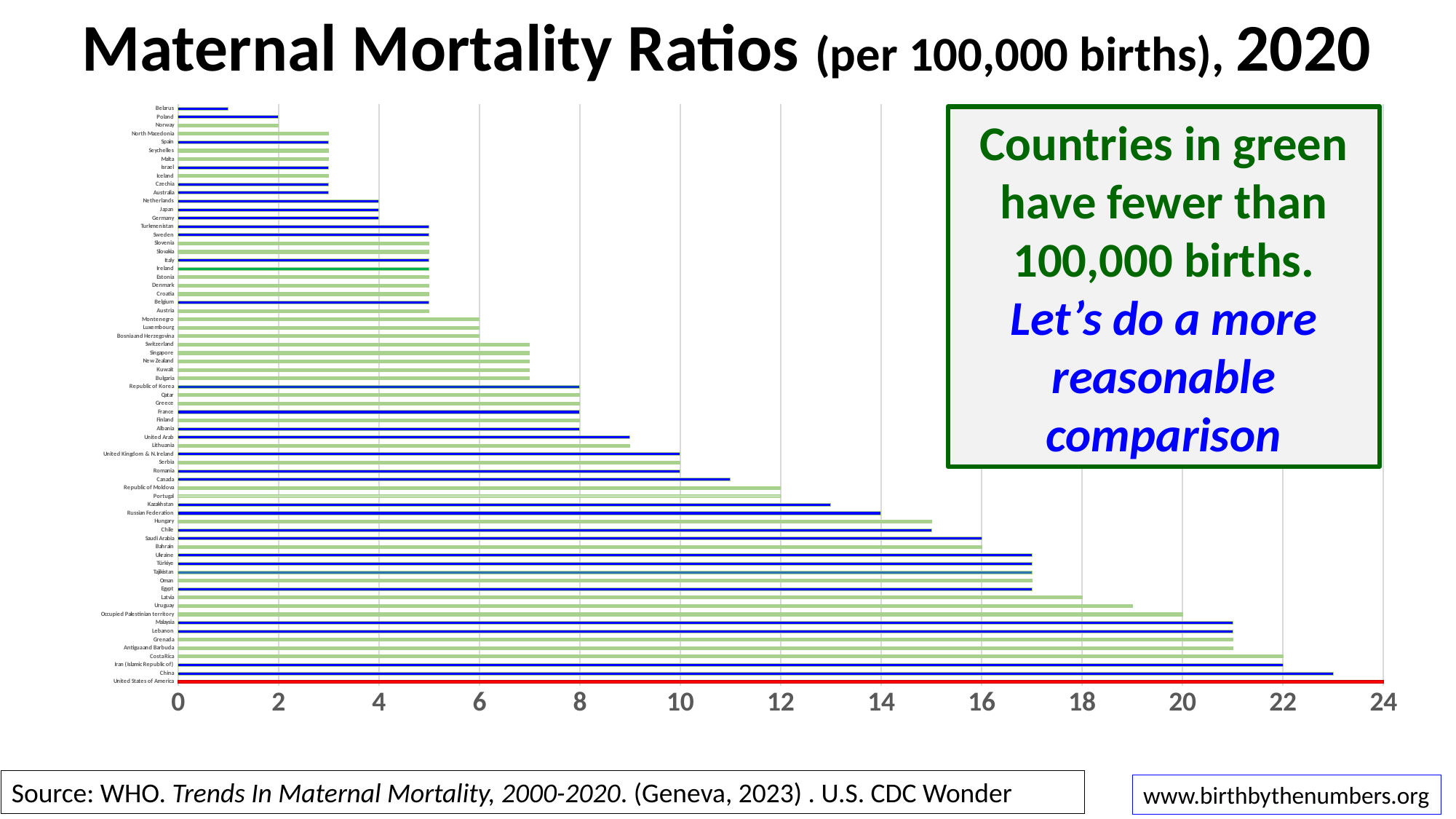
Which has a higher maternal mortality ratio, the United States of America or China? United States of America What is the difference between the maternal mortality ratios of the United States of America and Poland? 22 What is the maternal mortality ratio for the Russian Federation? 14 What is the maternal mortality ratio for Costa Rica? 22 Which country has the highest maternal mortality ratio on the chart? United States of America What colour is the bar for the United States of America? red What is the maternal mortality ratio for the United States of America? 24 Is the value for Canada greater or less than 10? greater Which country has the lowest maternal mortality ratio on the chart? Belarus What is the maternal mortality ratio for Poland? 2 Is the value for China greater or less than 22? greater What type of chart is shown on the slide? bar chart